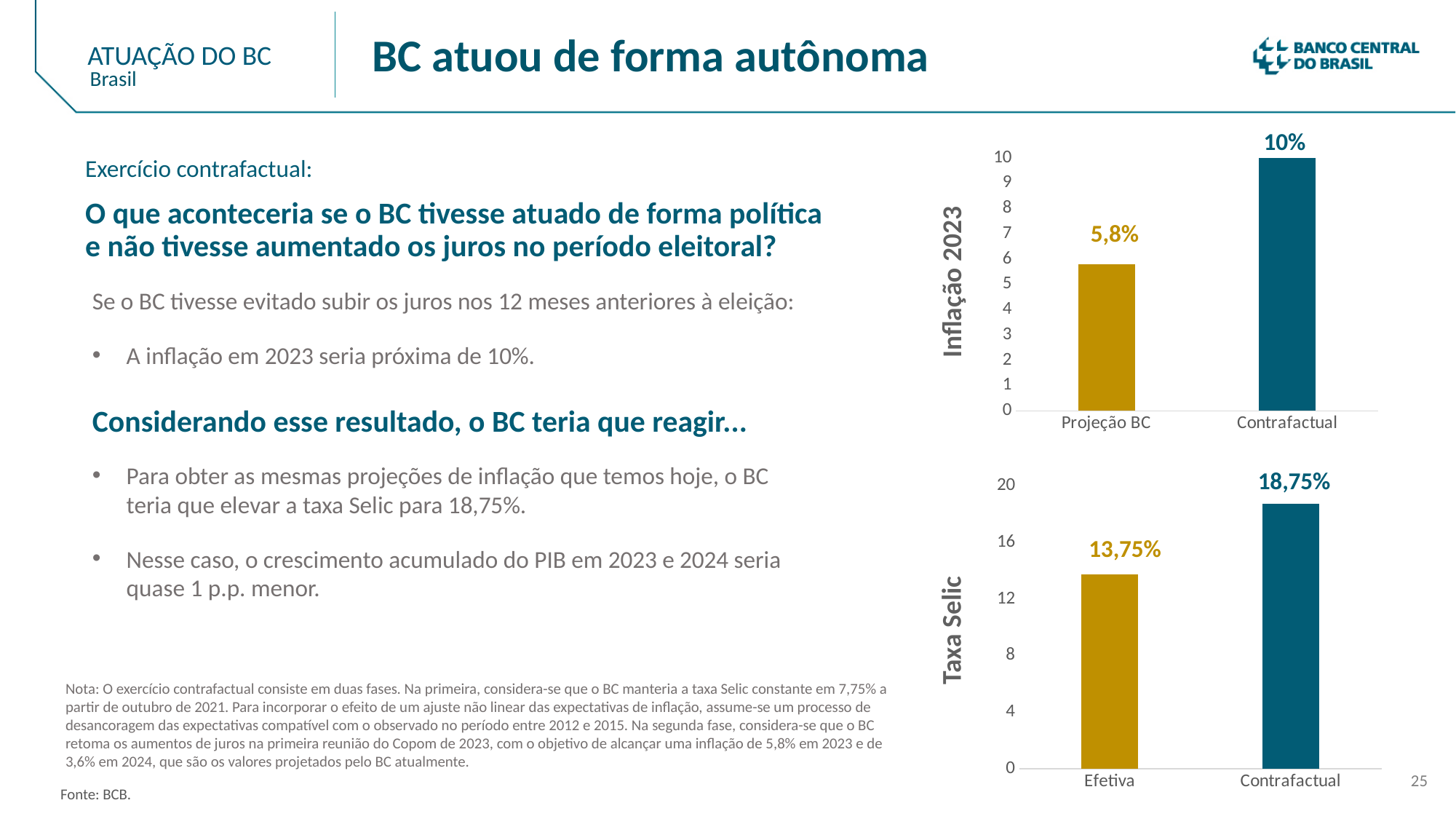
In the Taxa Selic chart, what is the value for Efetiva? 13,75% In the Inflação 2023 chart, which category has the higher value? Contrafactual In the Taxa Selic chart, what is the difference between the Contrafactual and Efetiva values? 5 p.p. What type of chart is the Taxa Selic chart? bar chart In the Inflação 2023 chart, what is the difference between the Contrafactual and Projeção BC values? 4,2 p.p. In the Taxa Selic chart, what colour is the Contrafactual bar? dark teal In the Taxa Selic chart, what is the value for Contrafactual? 18,75% In the Taxa Selic chart, is the value for Efetiva greater or less than 12? greater In the Taxa Selic chart, which category has the lower value? Efetiva In the Inflação 2023 chart, what is the value for Contrafactual? 10% How many bars are shown in the Inflação 2023 chart? 2 In the Inflação 2023 chart, what is the value for Projeção BC? 5,8%